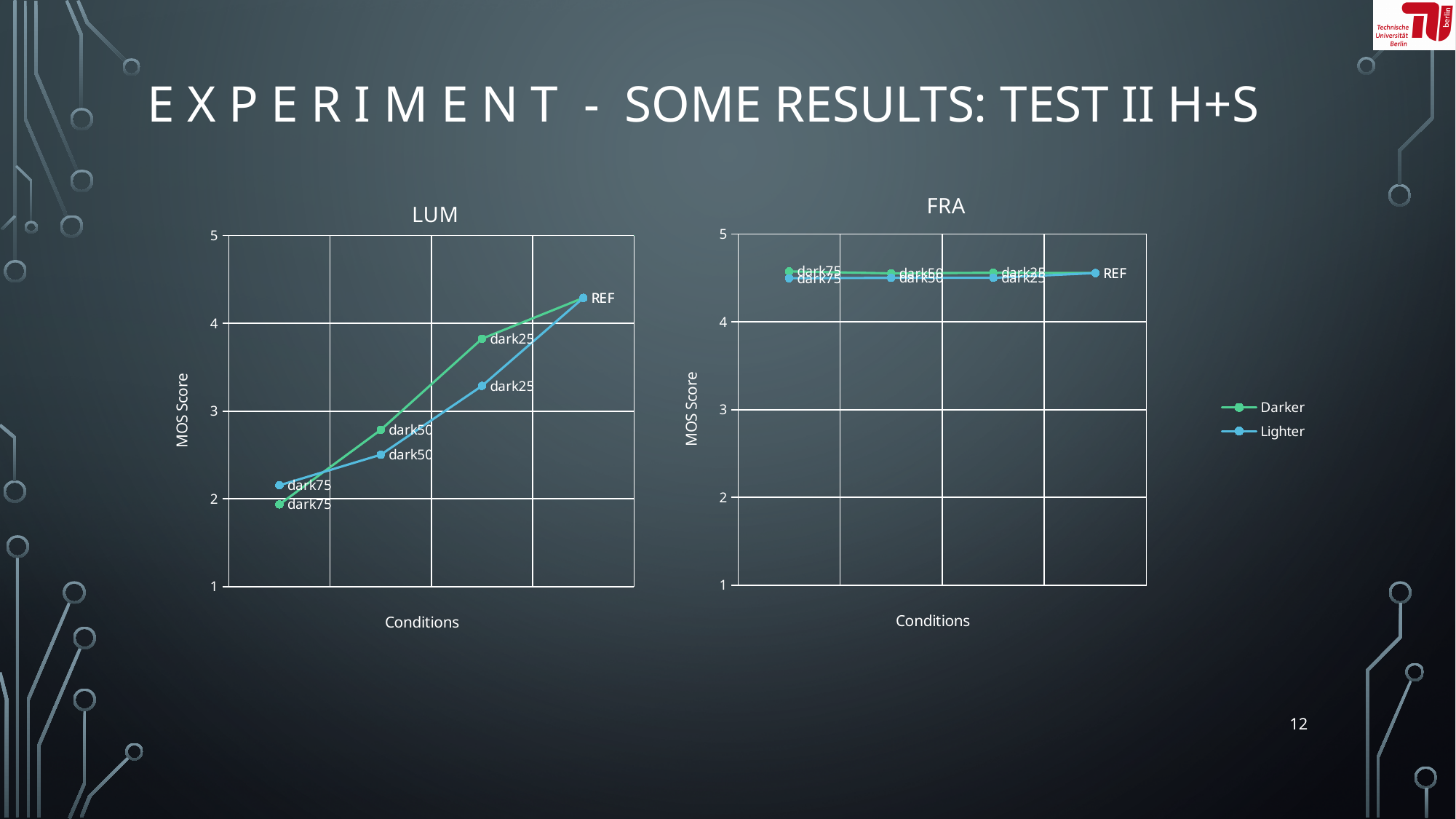
In the LUM chart, how many conditions are plotted for the Darker series? 4 In the LUM chart, do the Darker series values rise or fall from dark75 to REF? rise In the LUM chart, which condition has the highest Darker value? REF In the FRA chart, is the Darker value for dark75 greater or less than 4? greater In the LUM chart, which series has the larger value at dark25, Darker or Lighter? Darker What is the y-axis label of the FRA chart? MOS Score In the LUM chart, is the Lighter value for dark75 greater or less than 2? greater How many series does the legend list? 2 In the LUM chart, is the Darker value for dark75 greater or less than 2? less In the LUM chart, which series has the larger value at dark50, Darker or Lighter? Darker In the LUM chart, which condition has the lowest Darker value? dark75 What kind of chart is the LUM chart? line chart